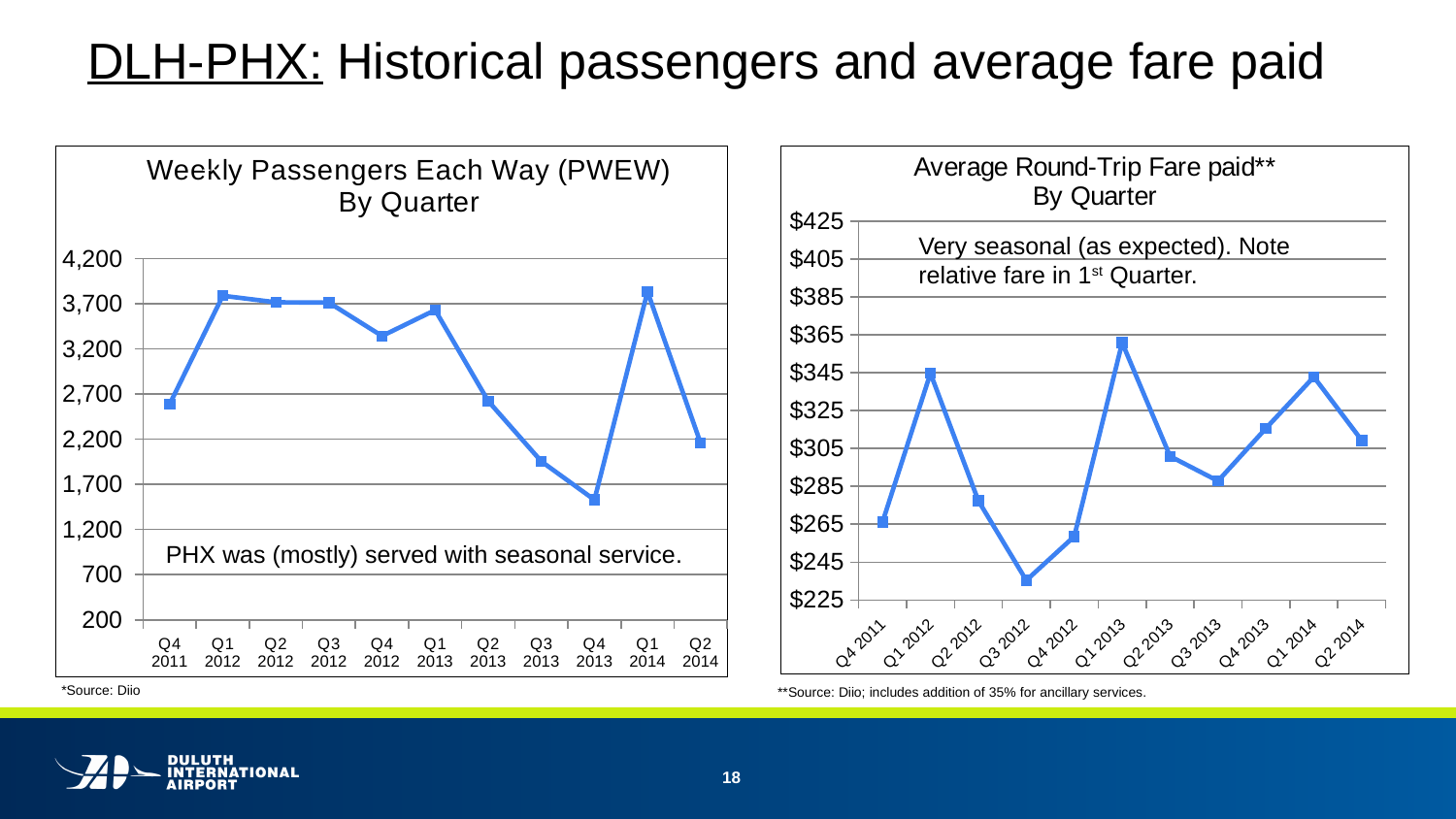
In the 'Average Round-Trip Fare paid By Quarter' chart, which quarter has the lowest fare? Q3 2012 What type of chart is the 'Weekly Passengers Each Way (PWEW) By Quarter' chart? line chart In the 'Average Round-Trip Fare paid By Quarter' chart, is the fare for Q1 2013 greater or less than $345? greater In the 'Weekly Passengers Each Way (PWEW) By Quarter' chart, is the value for Q4 2013 greater or less than 1,700? less In the 'Average Round-Trip Fare paid By Quarter' chart, which quarter has the highest fare? Q1 2013 In the 'Weekly Passengers Each Way (PWEW) By Quarter' chart, how many quarters are plotted? 11 In the 'Average Round-Trip Fare paid By Quarter' chart, which is larger, the fare for Q1 2012 or the fare for Q2 2012? Q1 2012 In the 'Weekly Passengers Each Way (PWEW) By Quarter' chart, which quarter has the lowest value? Q4 2013 In the 'Weekly Passengers Each Way (PWEW) By Quarter' chart, which is larger, the value for Q4 2012 or the value for Q2 2013? Q4 2012 In the 'Weekly Passengers Each Way (PWEW) By Quarter' chart, is the value for Q1 2012 greater or less than 3,700? greater In the 'Weekly Passengers Each Way (PWEW) By Quarter' chart, do the values rise or fall from Q1 2013 to Q4 2013? fall